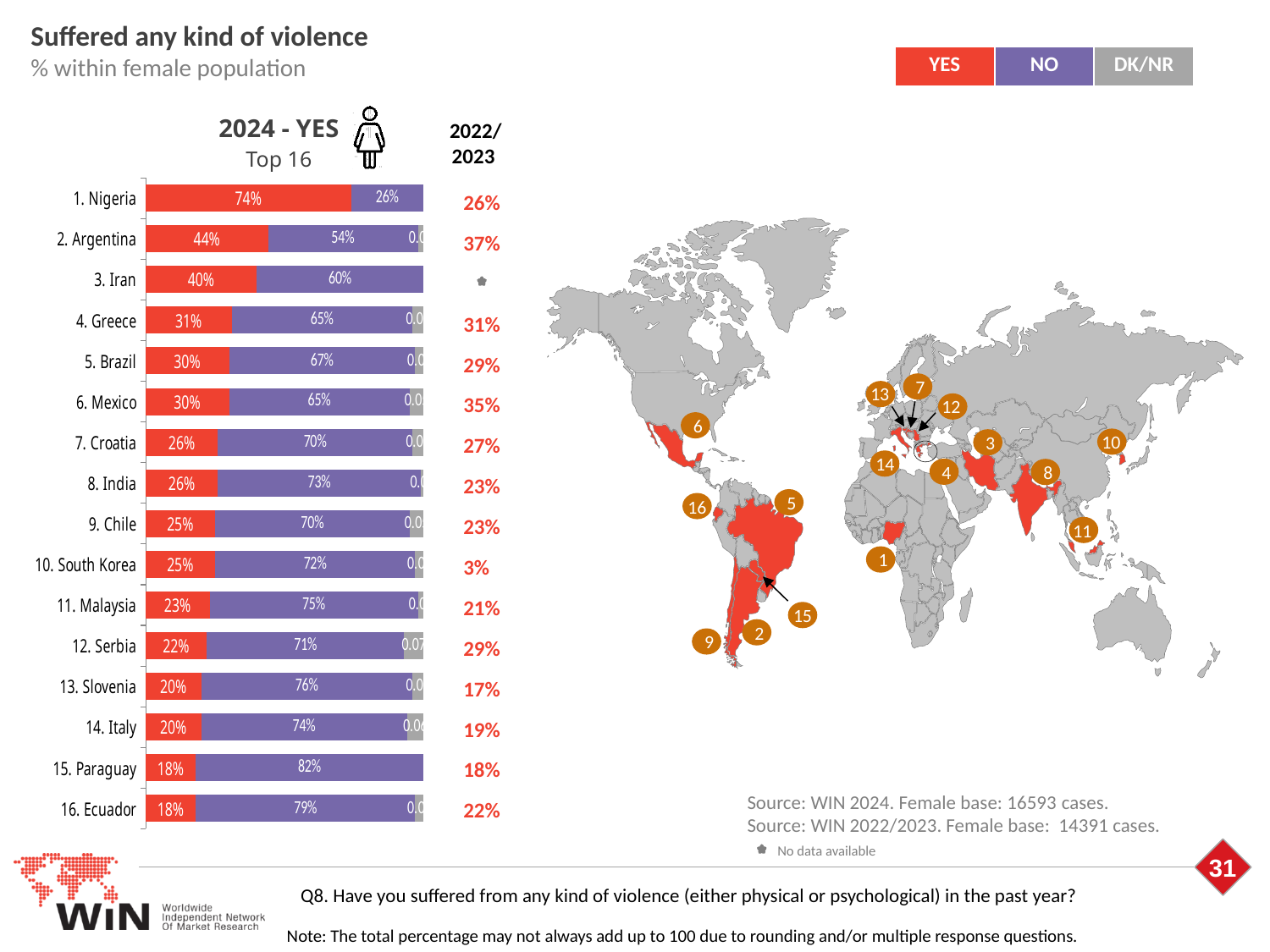
Which country has the highest YES value in the 2024 bar chart? Nigeria What kind of chart is used to show the 2024 results by country? Bar chart How many countries are shown in the 2024 bar chart? 16 Which country has the lowest NO value in the 2024 bar chart? Nigeria How many series does the legend list for the bar chart? 3 Which has the larger YES value in the 2024 bar chart, Greece or Brazil? Greece Which colour represents the YES series in the bar chart? Red What is the NO value for Iran in the 2024 bar chart? 60% What is the NO value for Paraguay in the 2024 bar chart? 82% What is the YES value for Nigeria in the 2024 bar chart? 74% What is the difference between the YES values for Nigeria and Argentina in the 2024 bar chart? 30 percentage points What is the 2022/2023 value shown for Mexico? 35%